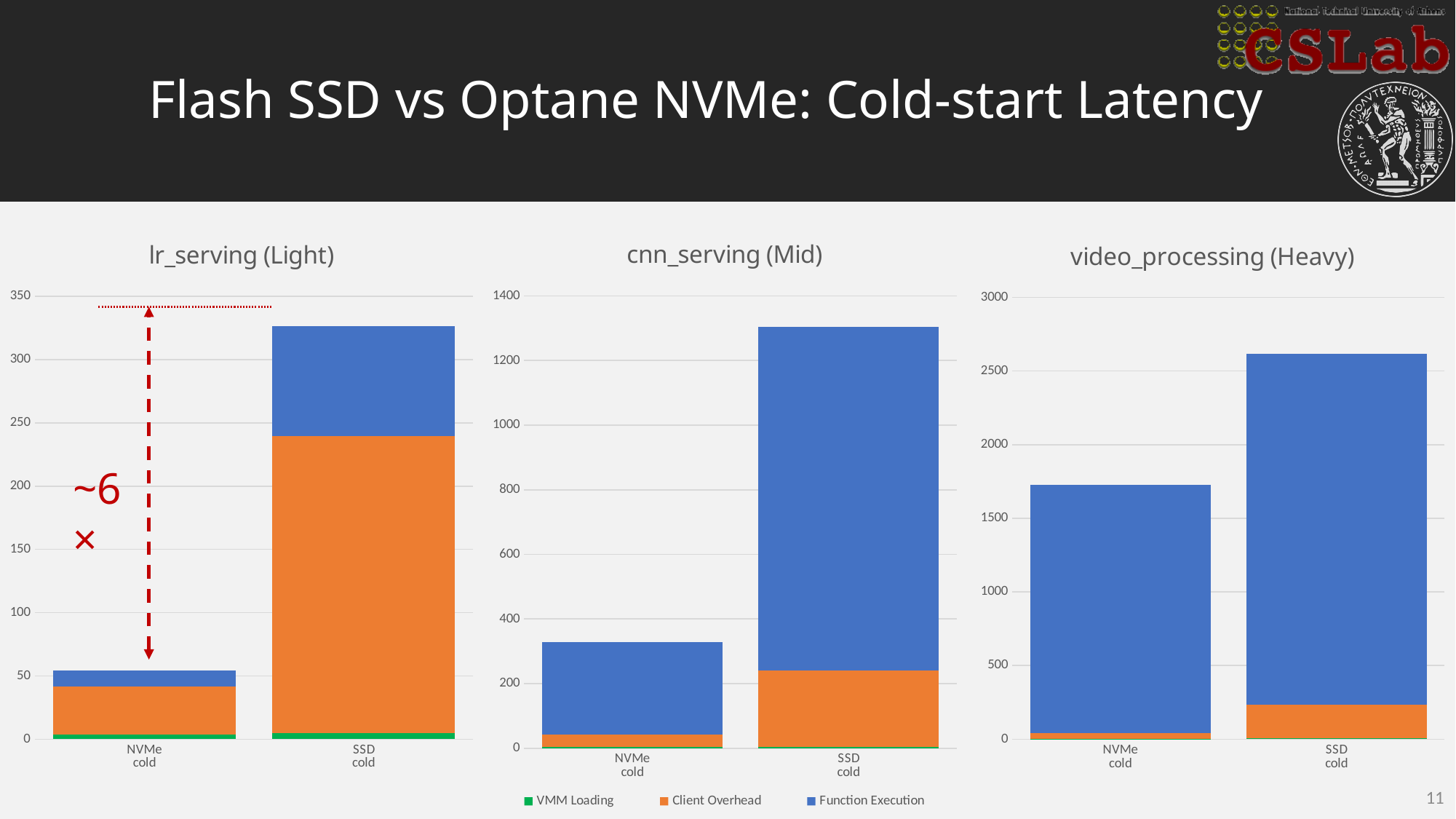
Which series is shown in orange in the legend? Client Overhead In the video_processing (Heavy) chart, which bar is taller, NVMe cold or SSD cold? SSD cold In the lr_serving (Light) chart, is the total for NVMe cold greater or less than 100? less How many series does the legend list? 3 In the video_processing (Heavy) chart, is the total for NVMe cold greater or less than 1500? greater In the cnn_serving (Mid) chart, is the total for NVMe cold greater or less than 400? less In the lr_serving (Light) chart, which bar is taller, NVMe cold or SSD cold? SSD cold How many categories are shown on the x axis of the cnn_serving (Mid) chart? 2 What kind of chart is the lr_serving (Light) chart? stacked bar chart What is the title of the rightmost chart? video_processing (Heavy)